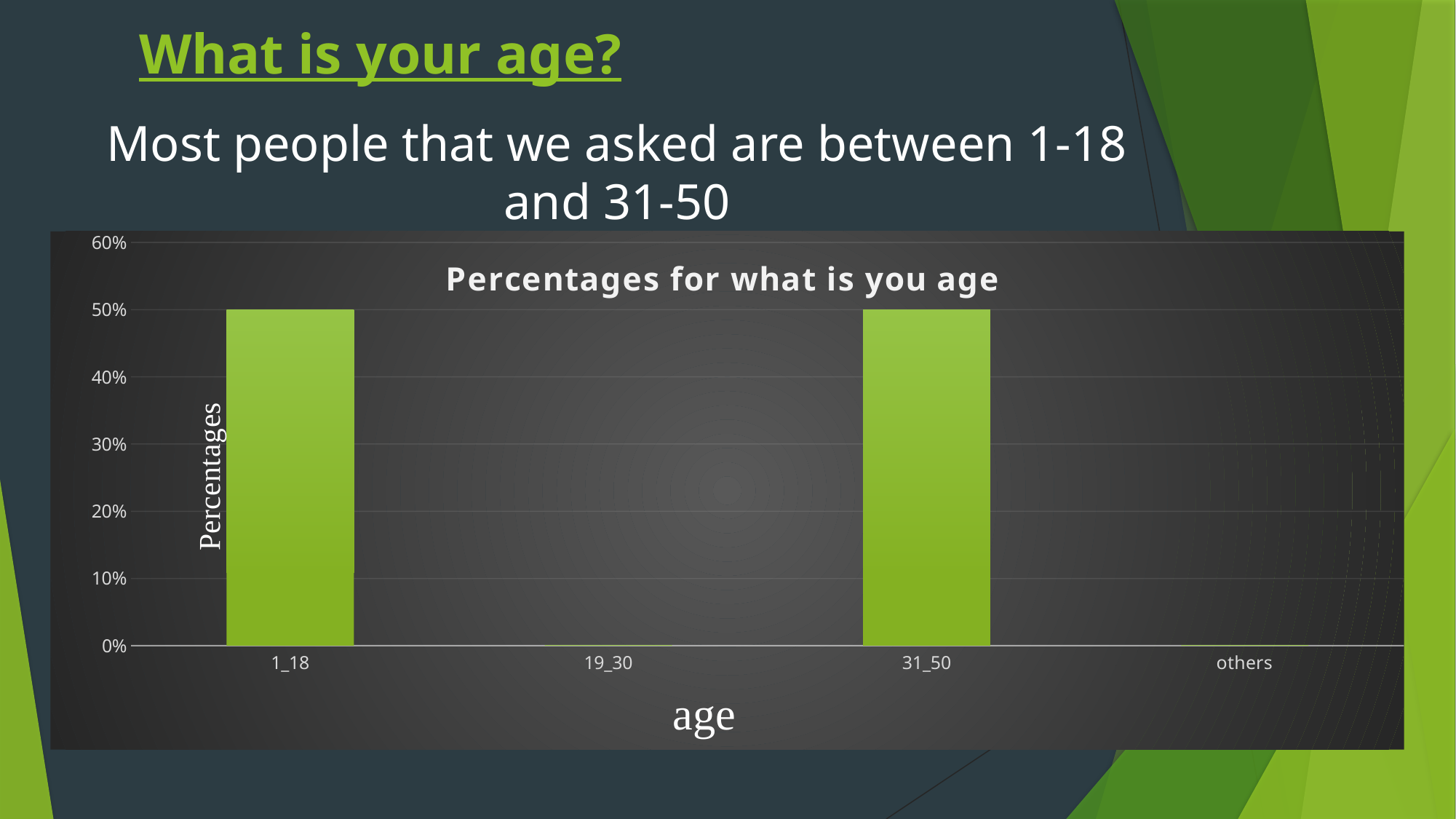
What is the value for the 1_18 category? 50% What kind of chart is shown on the slide? bar chart What is the value for the 31_50 category? 50% What is the label of the x axis? age Is the value for 19_30 greater or less than 10%? less Which is larger, the value for 1_18 or the value for 19_30? 1_18 Which is larger, the value for 31_50 or the value for others? 31_50 What is the title of the chart? Percentages for what is you age How many age categories are shown on the x axis? 4 Is the value for 1_18 greater or less than 40%? greater Is the value for others greater or less than 10%? less What is the highest value shown on the y axis? 60%